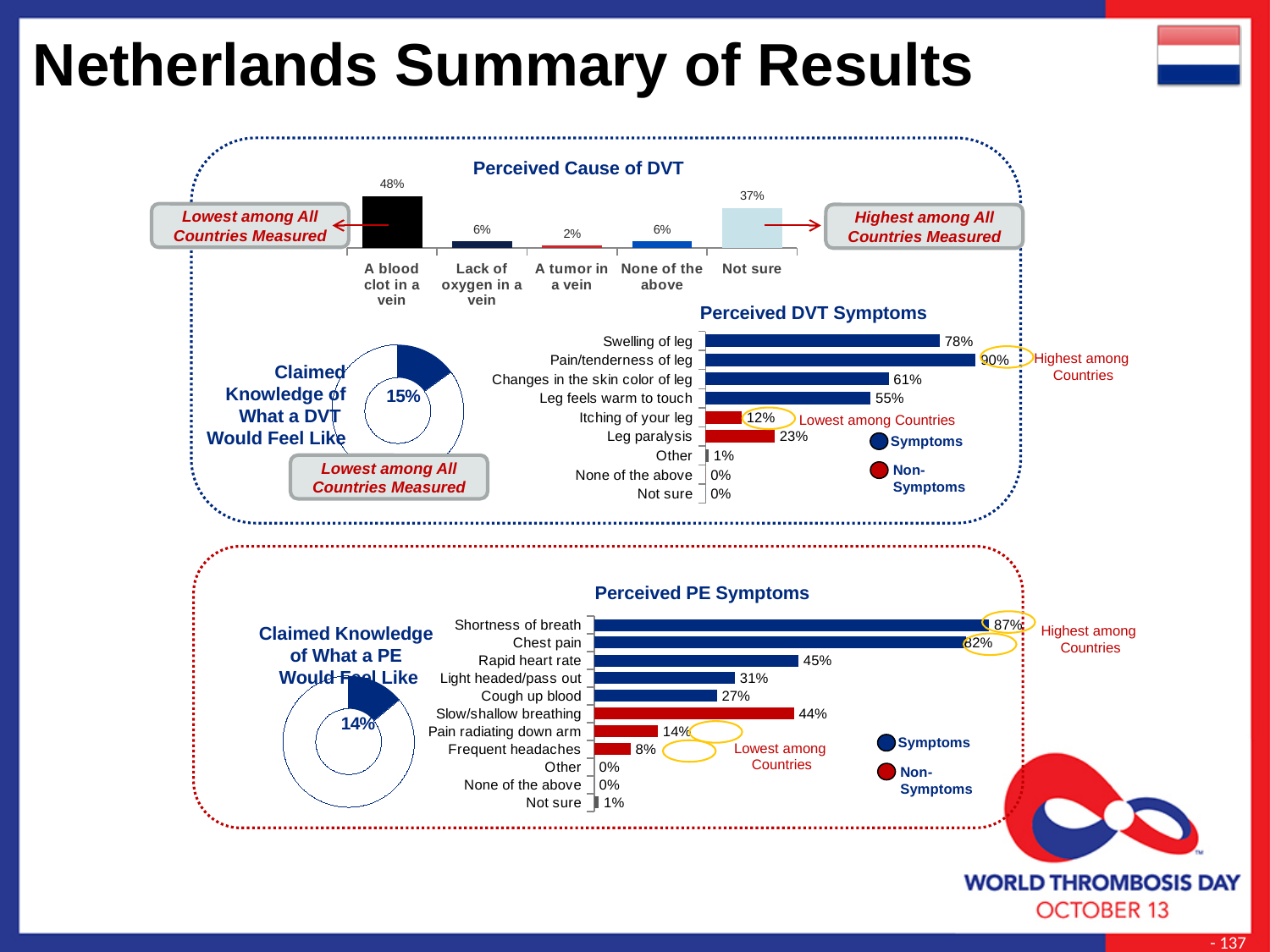
In the Perceived Cause of DVT chart, what percentage is shown for 'A blood clot in a vein'? 48% In the Perceived Cause of DVT chart, which category has the lowest value? A tumor in a vein In the Perceived Cause of DVT chart, what is the difference between 'A blood clot in a vein' and 'Not sure'? 11% How many categories are shown in the Perceived Cause of DVT chart? 5 In the Perceived DVT Symptoms chart, which symptom has the highest value? Pain/tenderness of leg What percentage is shown in the 'Claimed Knowledge of What a PE Would Feel Like' donut chart? 14% In the Perceived DVT Symptoms chart, what percentage is shown for 'Pain/tenderness of leg'? 90% In the Perceived PE Symptoms chart, what percentage is shown for 'Chest pain'? 82% How many series does the legend of the Perceived PE Symptoms chart list? 2 In the Perceived DVT Symptoms chart, which is larger: 'Itching of your leg' or 'Leg paralysis'? Leg paralysis In the Perceived PE Symptoms chart, what is the difference between 'Rapid heart rate' and 'Light headed/pass out'? 14% What kind of chart is the Perceived DVT Symptoms chart? Bar chart